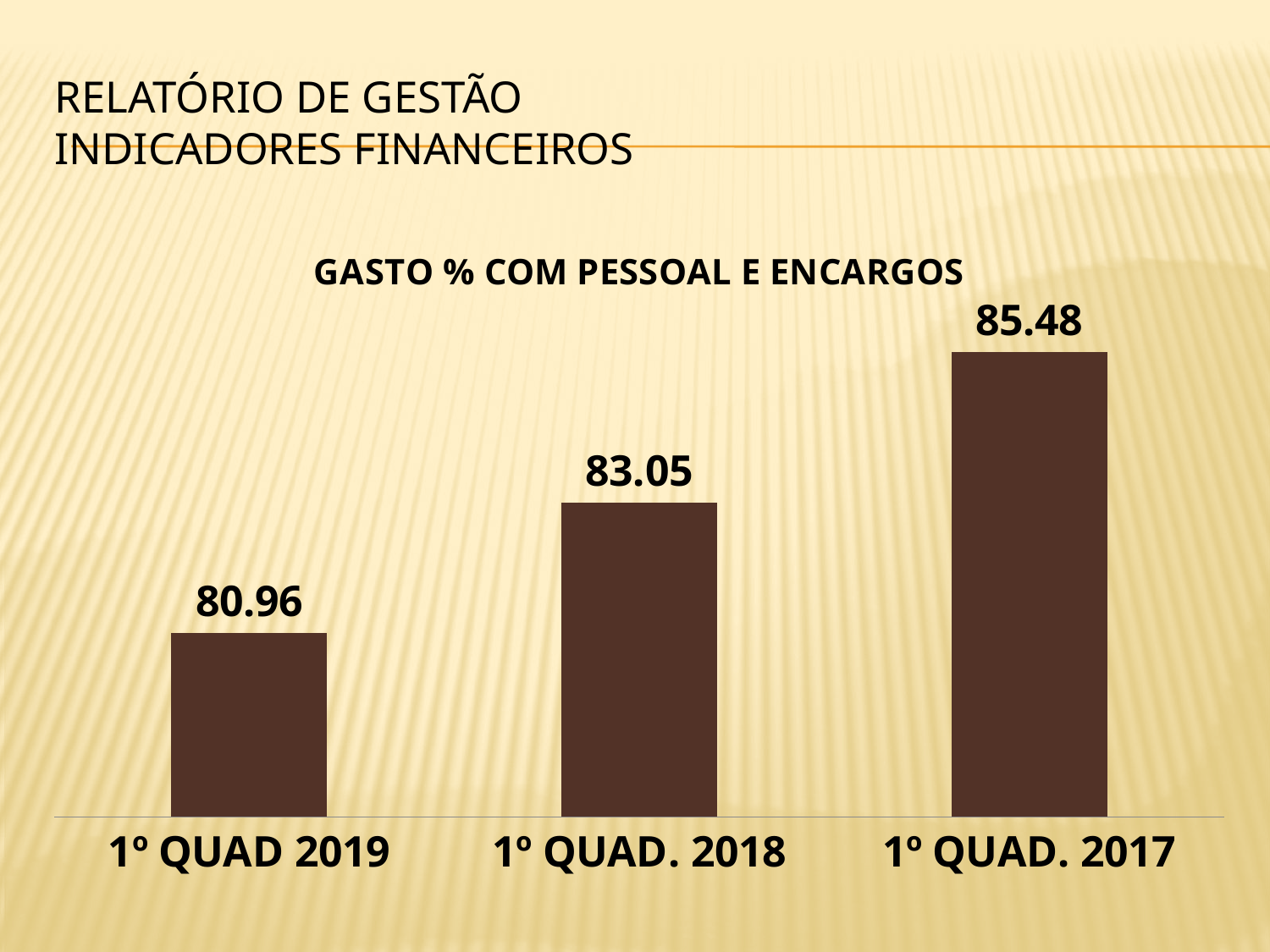
What is the value for 1º QUAD. 2018? 83.05 Which category has the lowest value? 1º QUAD 2019 What is the title of the chart? GASTO % COM PESSOAL E ENCARGOS What is the difference between the values for 1º QUAD. 2018 and 1º QUAD 2019? 2.09 What is the difference between the values for 1º QUAD. 2017 and 1º QUAD 2019? 4.52 How many categories are shown in the chart? 3 What is the value for 1º QUAD. 2017? 85.48 Which category has the highest value? 1º QUAD. 2017 Which is larger, the value for 1º QUAD. 2018 or the value for 1º QUAD. 2017? 1º QUAD. 2017 What is the value for 1º QUAD 2019? 80.96 What kind of chart is shown on the slide? Bar chart Do the values rise or fall from left to right along the x axis? Rise